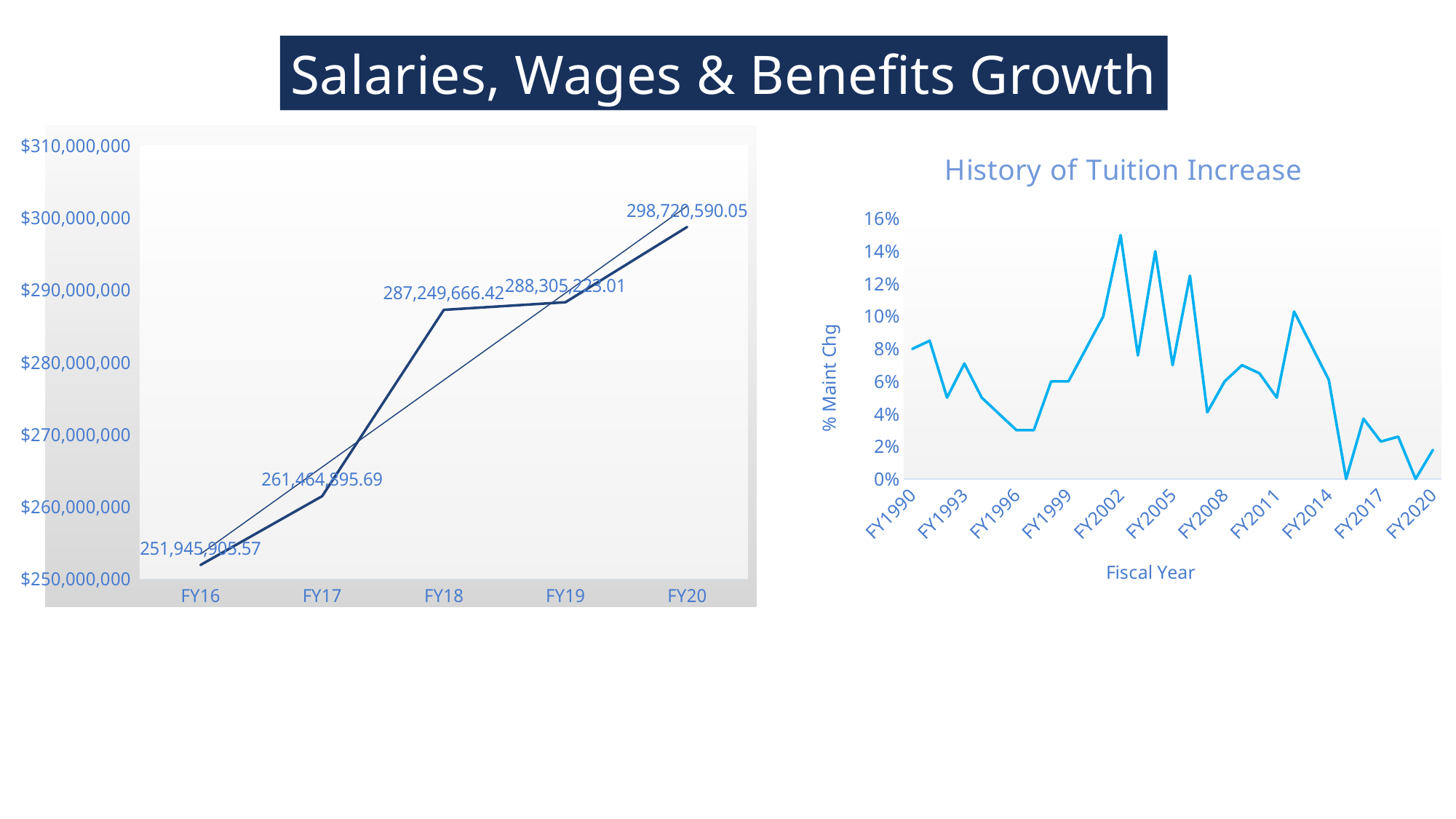
On the Salaries, Wages & Benefits Growth chart, do the values rise or fall from FY16 to FY20? rise What kind of chart is the History of Tuition Increase chart? line chart On the Salaries, Wages & Benefits Growth chart, which fiscal year has the highest value? FY20 On the Salaries, Wages & Benefits Growth chart, what is the value for FY18? 287,249,666.42 What is the label on the vertical axis of the History of Tuition Increase chart? % Maint Chg On the History of Tuition Increase chart, is the value for FY1990 greater or less than 6%? greater On the Salaries, Wages & Benefits Growth chart, which fiscal year has the lowest value? FY16 On the Salaries, Wages & Benefits Growth chart, what is the difference between the FY20 and FY18 values? 11,470,923.63 On the Salaries, Wages & Benefits Growth chart, what is the value for FY20? 298,720,590.05 On the Salaries, Wages & Benefits Growth chart, how many fiscal years are plotted? 5 On the History of Tuition Increase chart, which is larger, the value for FY2002 or the value for FY2020? FY2002 On the History of Tuition Increase chart, is the value for FY2020 greater or less than 4%? less